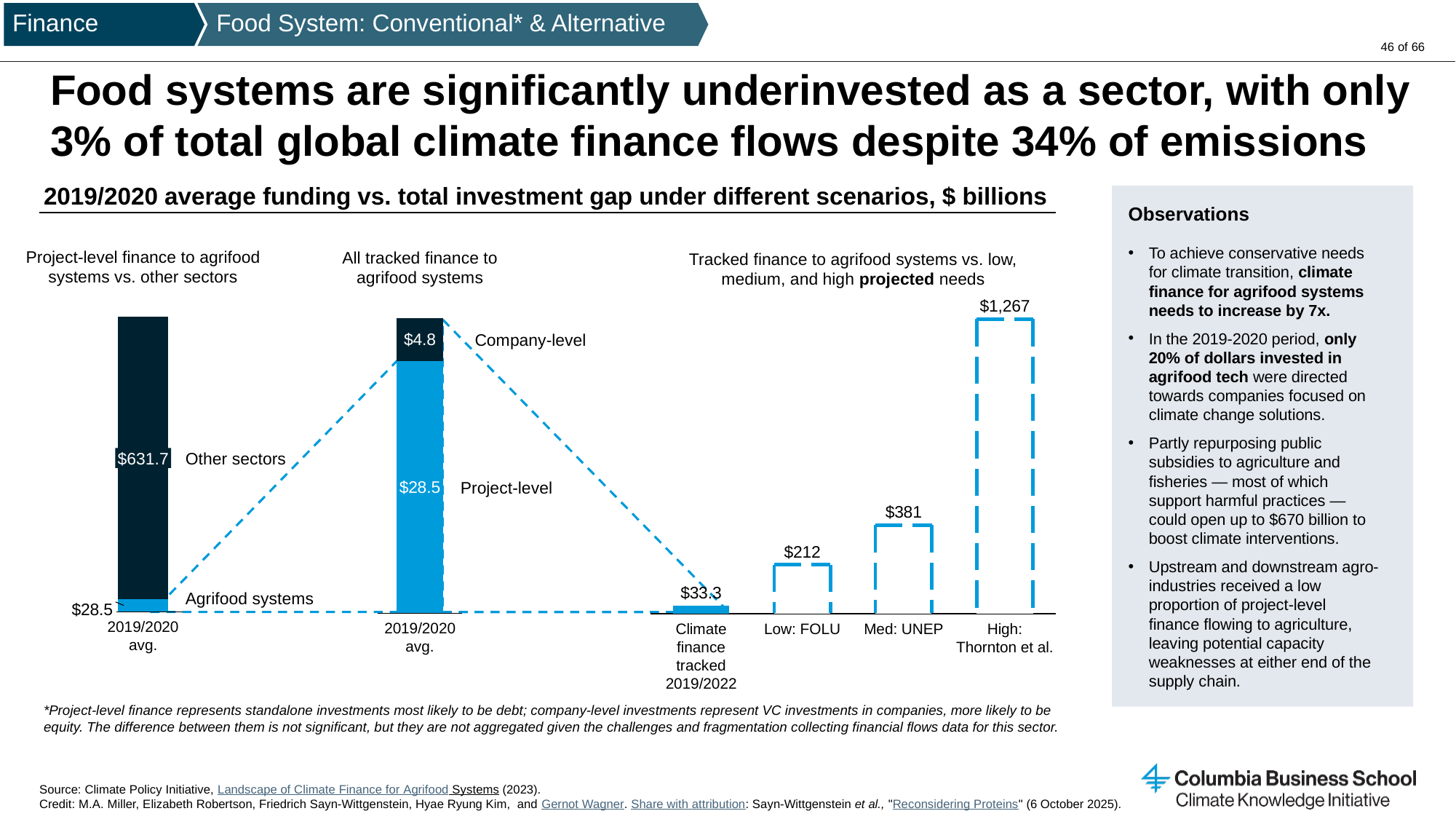
In the 'Tracked finance to agrifood systems vs. low, medium, and high projected needs' chart, which category has the lowest value? Climate finance tracked 2019/2022 In the 'Tracked finance to agrifood systems vs. low, medium, and high projected needs' chart, what is the difference between Med: UNEP and Low: FOLU? $169 In the 'Project-level finance to agrifood systems vs. other sectors' chart, what is the value for Agrifood systems? $28.5 What is the title of the chart on this slide? 2019/2020 average funding vs. total investment gap under different scenarios, $ billions What kind of chart is used on this slide? Bar chart In the 'Tracked finance to agrifood systems vs. low, medium, and high projected needs' chart, which category has the highest value? High: Thornton et al. In the 'All tracked finance to agrifood systems' chart, what is the Company-level value? $4.8 In the 'Project-level finance to agrifood systems vs. other sectors' chart, what is the total of the stacked 2019/2020 avg. bar? $660.2 In the 'Tracked finance to agrifood systems vs. low, medium, and high projected needs' chart, what is the value for High: Thornton et al.? $1,267 In the 'All tracked finance to agrifood systems' chart, what is the total of the stacked 2019/2020 avg. bar? $33.3 In the 'Tracked finance to agrifood systems vs. low, medium, and high projected needs' chart, how many bars are shown? 4 In the 'Project-level finance to agrifood systems vs. other sectors' chart, what is the value for Other sectors? $631.7